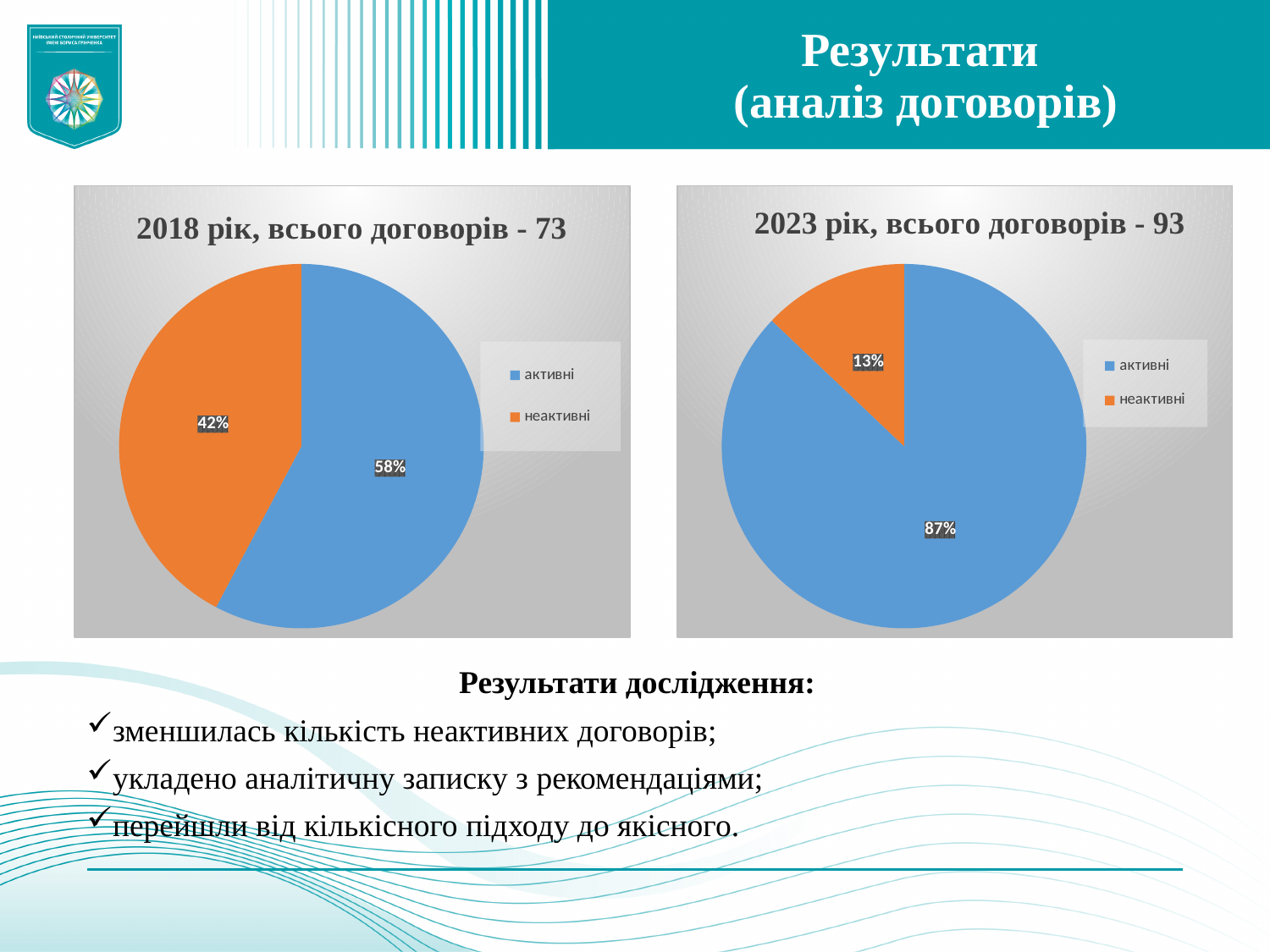
Which chart has the larger share of "неактивні": the left chart (2018) or the right chart (2023)? the left chart (2018) In the left chart titled "2018 рік, всього договорів - 73", what share of the pie is "активні"? 58% What is the title of the right chart? 2023 рік, всього договорів - 93 In the left chart (2018), what is the difference in percentage points between the "активні" and "неактивні" slices? 16 In the left chart (2018), which category has the largest slice? активні What type of chart is the left chart titled "2018 рік, всього договорів - 73"? pie chart In the right chart (2023), which category has the smallest slice? неактивні In the right chart titled "2023 рік, всього договорів - 93", what share of the pie is "активні"? 87% In the right chart titled "2023 рік, всього договорів - 93", what share of the pie is "неактивні"? 13% In the right chart (2023), what is the difference in percentage points between the "активні" and "неактивні" slices? 74 How many categories does the legend of the right chart (2023) list? 2